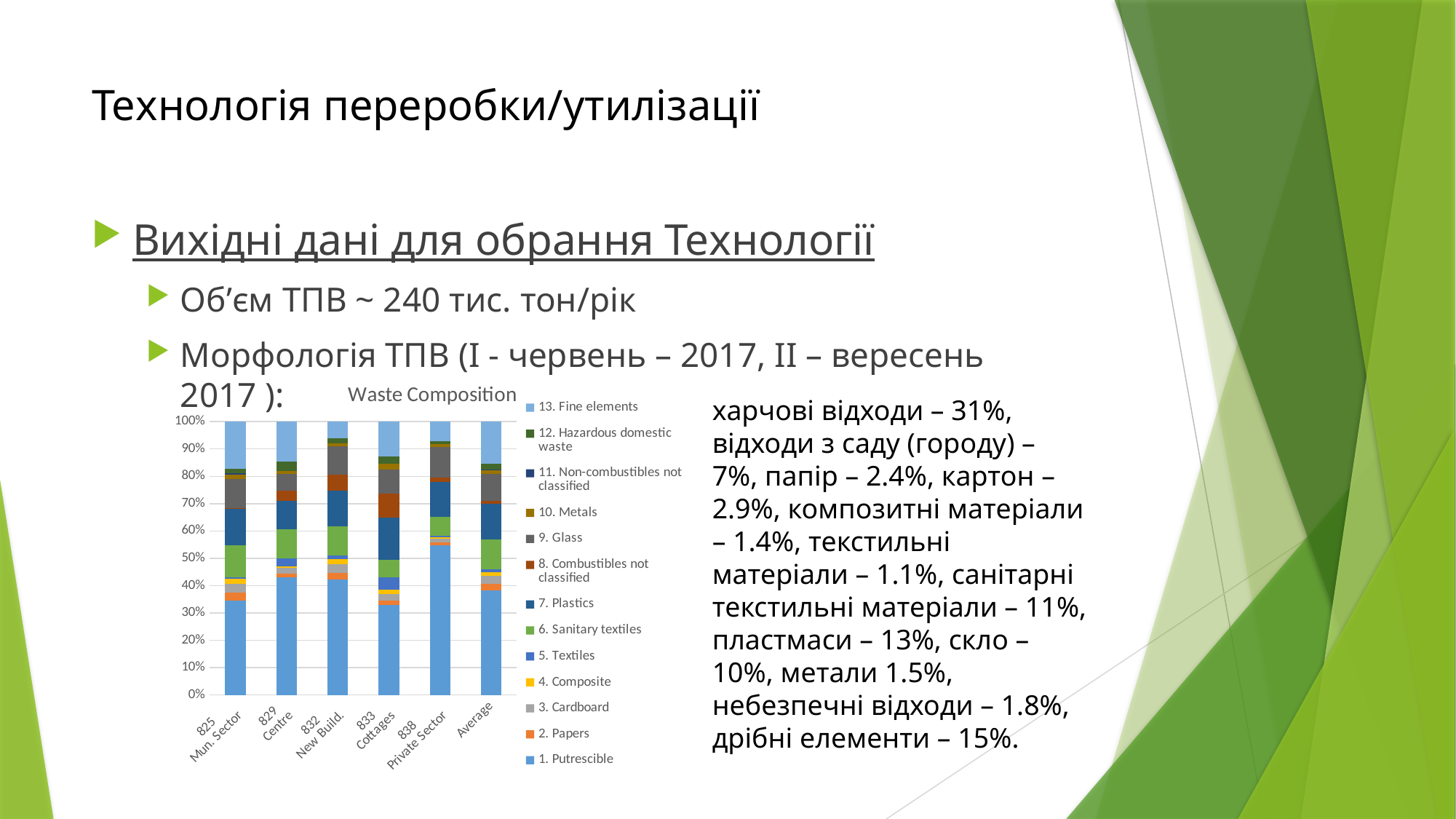
Which series is listed at the bottom of the legend in the Waste Composition chart? 1. Putrescible In the Waste Composition chart, what is the total height of each stacked bar? 100% How many series does the legend of the Waste Composition chart list? 13 In the Waste Composition chart, is the Putrescible share for 838 Private Sector greater or less than 50%? greater In the Waste Composition chart, is the Putrescible share for 825 Mun. Sector greater or less than 40%? less In the Waste Composition chart, is the Putrescible share for 833 Cottages greater or less than 40%? less How many categories are shown on the x axis of the Waste Composition chart? 6 What type of chart is shown on the slide? Stacked bar chart In the Waste Composition chart, which category has the largest Putrescible share? 838 Private Sector What is the title of the chart on the slide? Waste Composition In the Waste Composition chart, which has the larger Putrescible share: 838 Private Sector or 829 Centre? 838 Private Sector